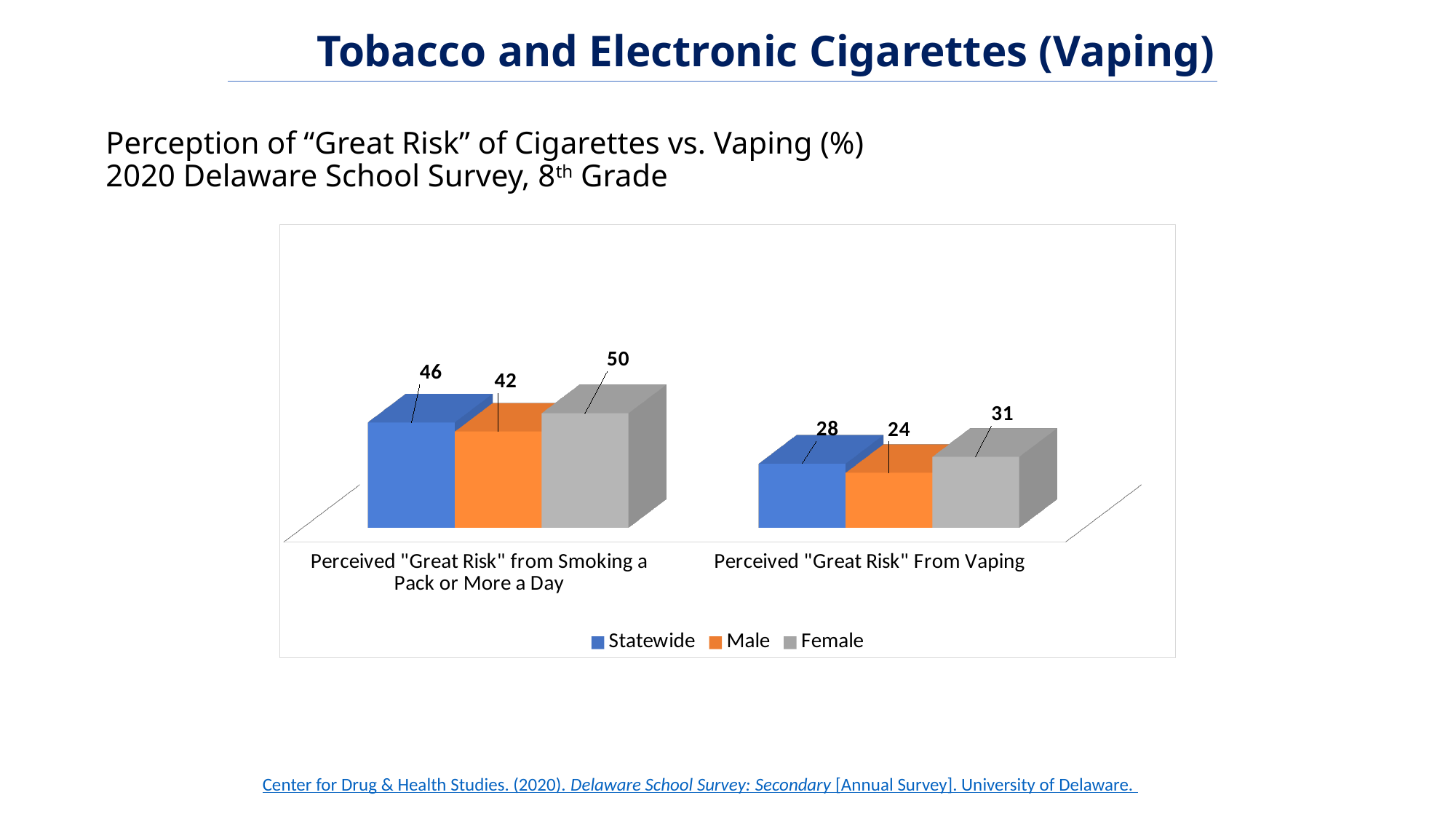
What kind of chart is shown on the slide? Bar chart What is the difference between the Female and Male values for Perceived "Great Risk" from Smoking a Pack or More a Day? 8 What is the Male value for Perceived "Great Risk" from Smoking a Pack or More a Day? 42 Which series has the lowest value for Perceived "Great Risk" from Smoking a Pack or More a Day? Male Which series has the highest value for Perceived "Great Risk" From Vaping? Female Is the Statewide value larger for Perceived "Great Risk" from Smoking a Pack or More a Day or for Perceived "Great Risk" From Vaping? Perceived "Great Risk" from Smoking a Pack or More a Day How many categories are shown on the x axis? 2 What is the Statewide value for Perceived "Great Risk" from Smoking a Pack or More a Day? 46 What is the difference between the Statewide values for Smoking a Pack or More a Day and Vaping? 18 Which colour represents the Male series in the chart? Orange How many series does the legend list? 3 What is the Female value for Perceived "Great Risk" From Vaping? 31